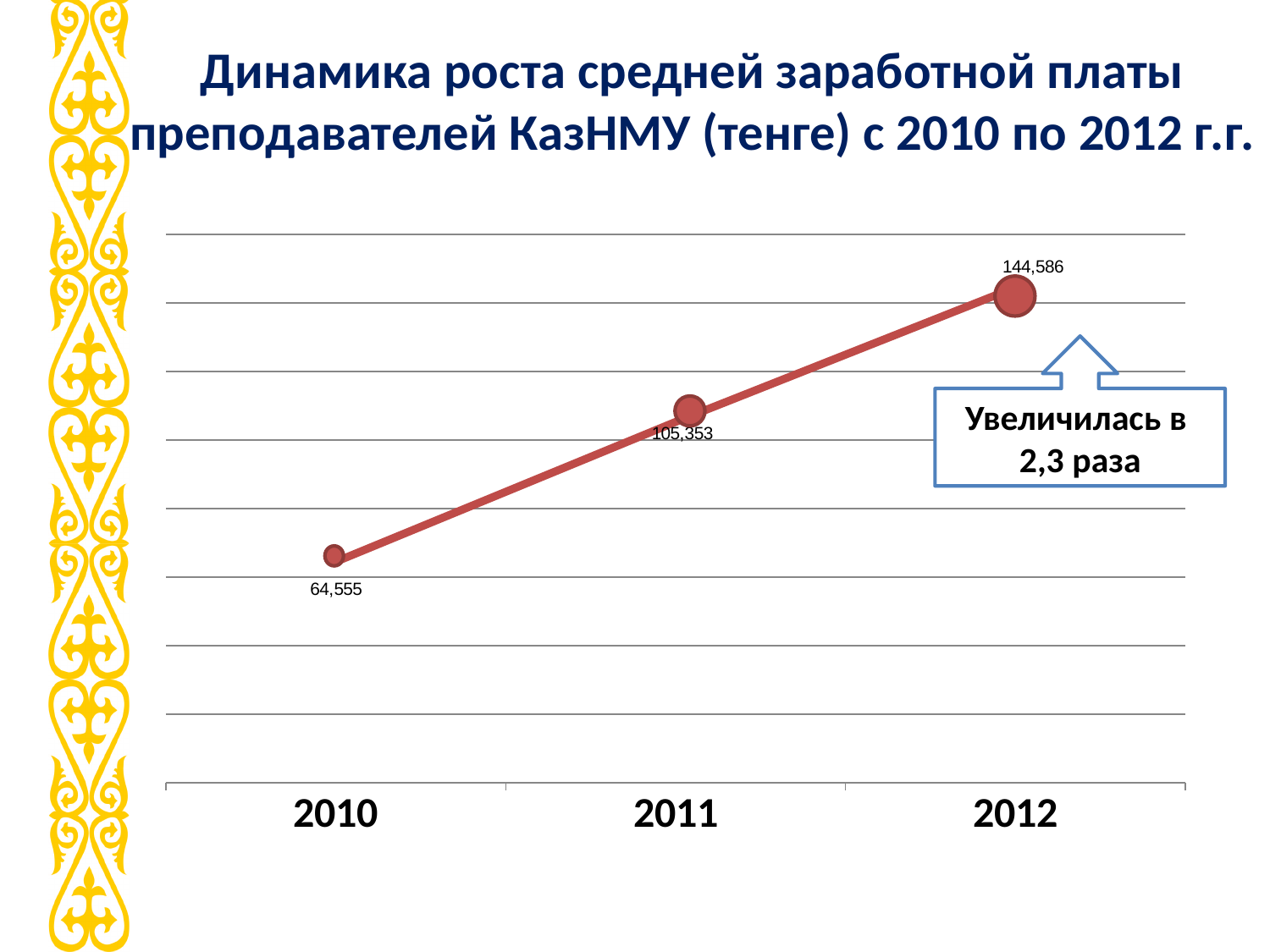
What is the difference between the 2012 and 2011 values? 39,233 What type of chart is shown on the slide? line chart What was the average salary of KazNMU teachers in 2010? 64,555 Do the values rise or fall from 2010 to 2012? rise Which year has the lowest average salary? 2010 What was the average salary of KazNMU teachers in 2011? 105,353 By how much did the average salary increase from 2010 to 2012? 80,031 Which year has a larger value, 2011 or 2012? 2012 What is the difference between the 2011 and 2010 values? 40,798 How many years are plotted on the chart? 3 What was the average salary of KazNMU teachers in 2012? 144,586 Which year has the highest average salary? 2012